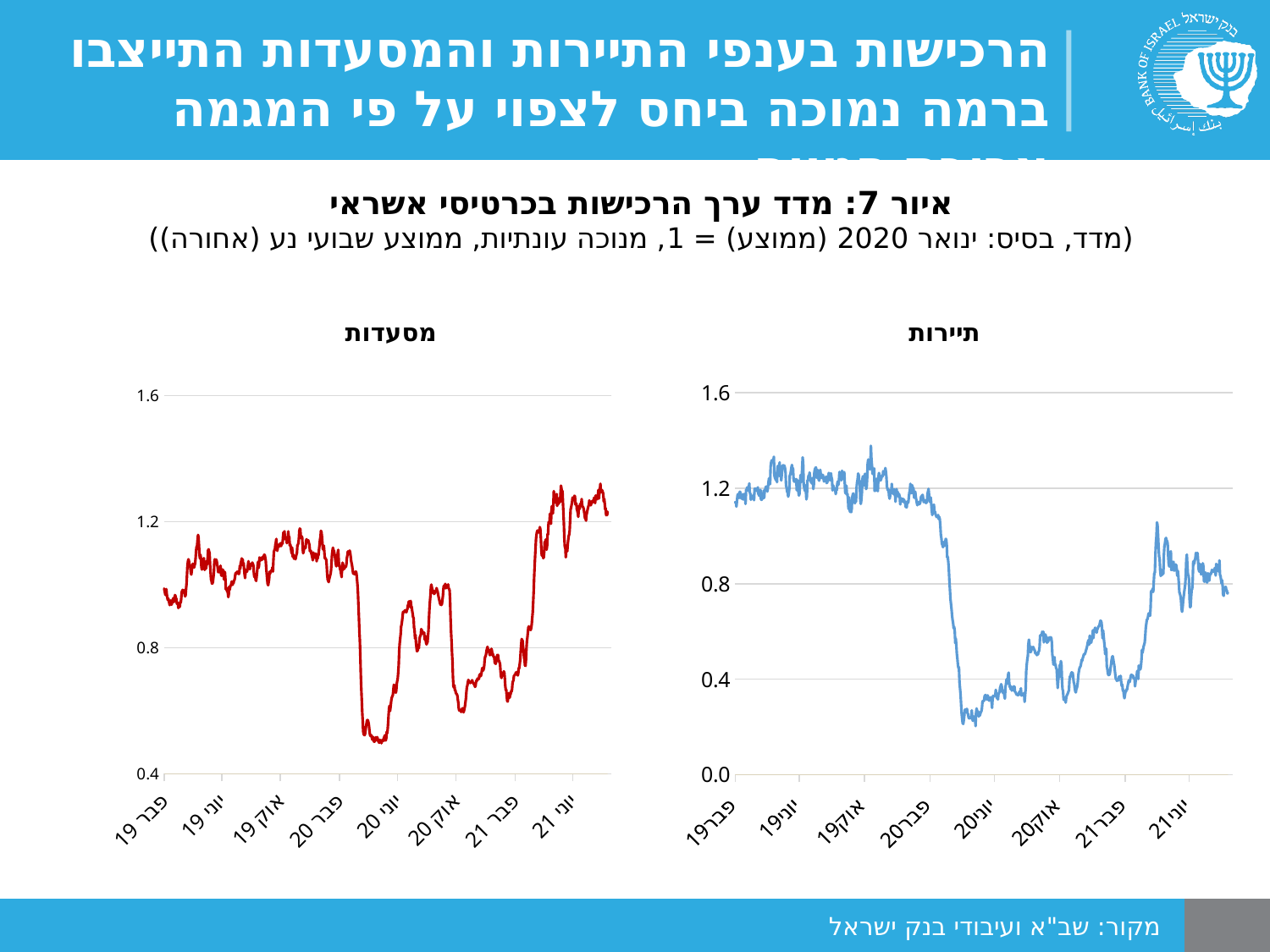
On the 'מסעדות' chart, how many labels are shown on the x axis? 8 What is the figure number given in the chart title above the two charts? איור 7 On the 'תיירות' chart, is the lowest point of the line greater or less than 0.4? less What colour is the line on the 'מסעדות' chart? red What kind of chart is the 'מסעדות' chart on the left? line chart What kind of chart is the 'תיירות' chart on the right? line chart On the 'תיירות' chart, how many labels are shown on the x axis? 8 On the 'מסעדות' chart, is the lowest point of the line greater or less than 0.8? less On the 'תיירות' chart, is the value at the end of the series (יוני 21) higher or lower than at the start (פבר 19)? lower On the 'תיירות' chart, is the value at יוני 20 greater or less than 0.8? less